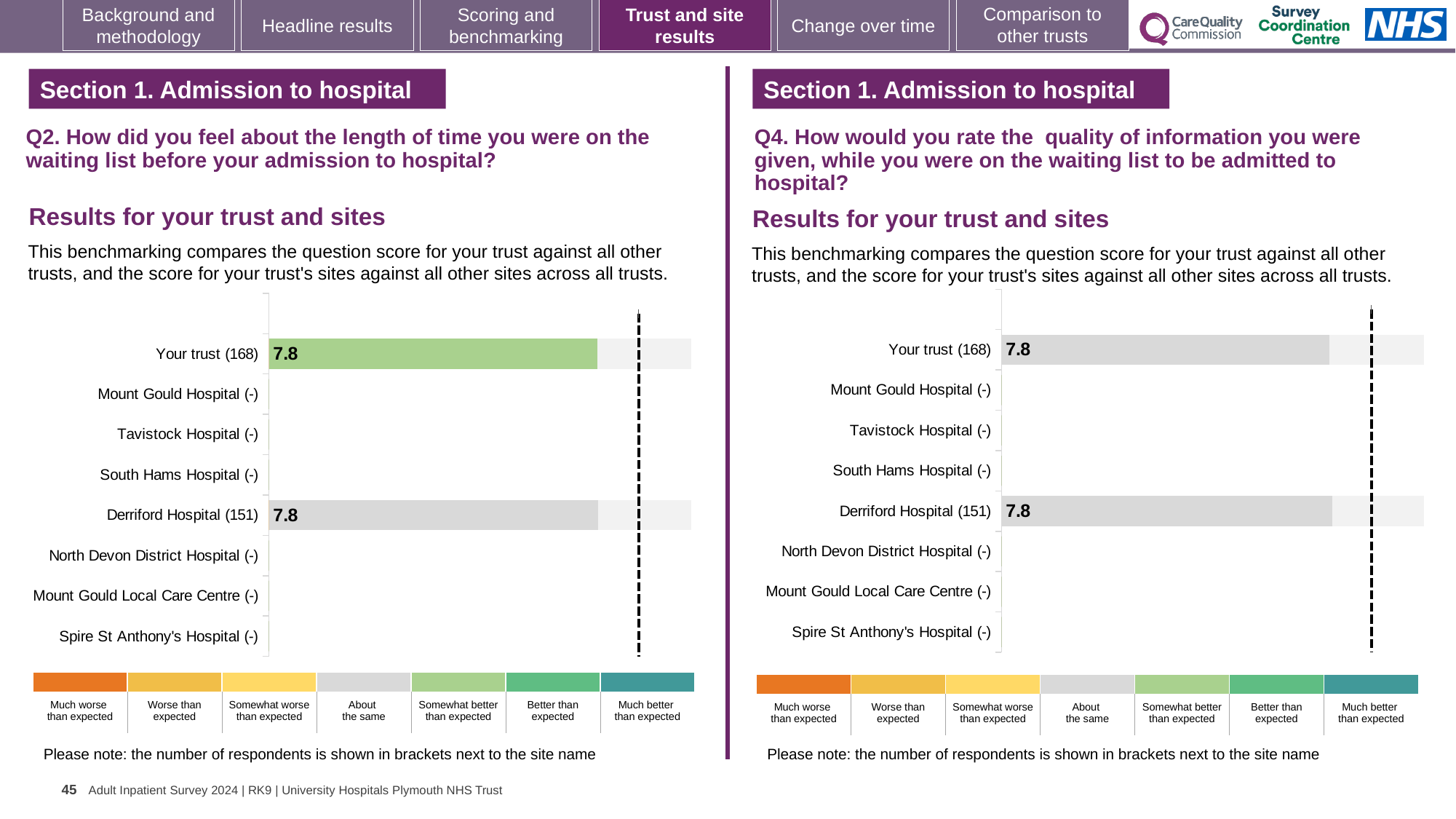
How many site/trust categories are listed on the Q2 chart (left)? 8 On the Q4 chart (right), which benchmark category does the colour of the Your trust (168) bar correspond to? About the same On the Q4 chart (right), what is the score for Your trust (168)? 7.8 On the Q2 chart (left), what is the score for Derriford Hospital (151)? 7.8 On the Q4 chart (right), what is the difference between the score for Your trust (168) and the score for Derriford Hospital (151)? 0 On the Q2 chart (left), which benchmark category does the colour of the Your trust (168) bar correspond to? Somewhat better than expected On the Q4 chart (right), what is the score for Derriford Hospital (151)? 7.8 How many site/trust categories are listed on the Q4 chart (right)? 8 On the Q2 chart (left), how many categories have a plotted bar with a value shown? 2 On the Q2 chart (left), what is the difference between the score for Your trust (168) and the score for Derriford Hospital (151)? 0 What kind of chart is the Q2 chart (left)? Bar chart On the Q2 chart (left), what is the score for Your trust (168)? 7.8